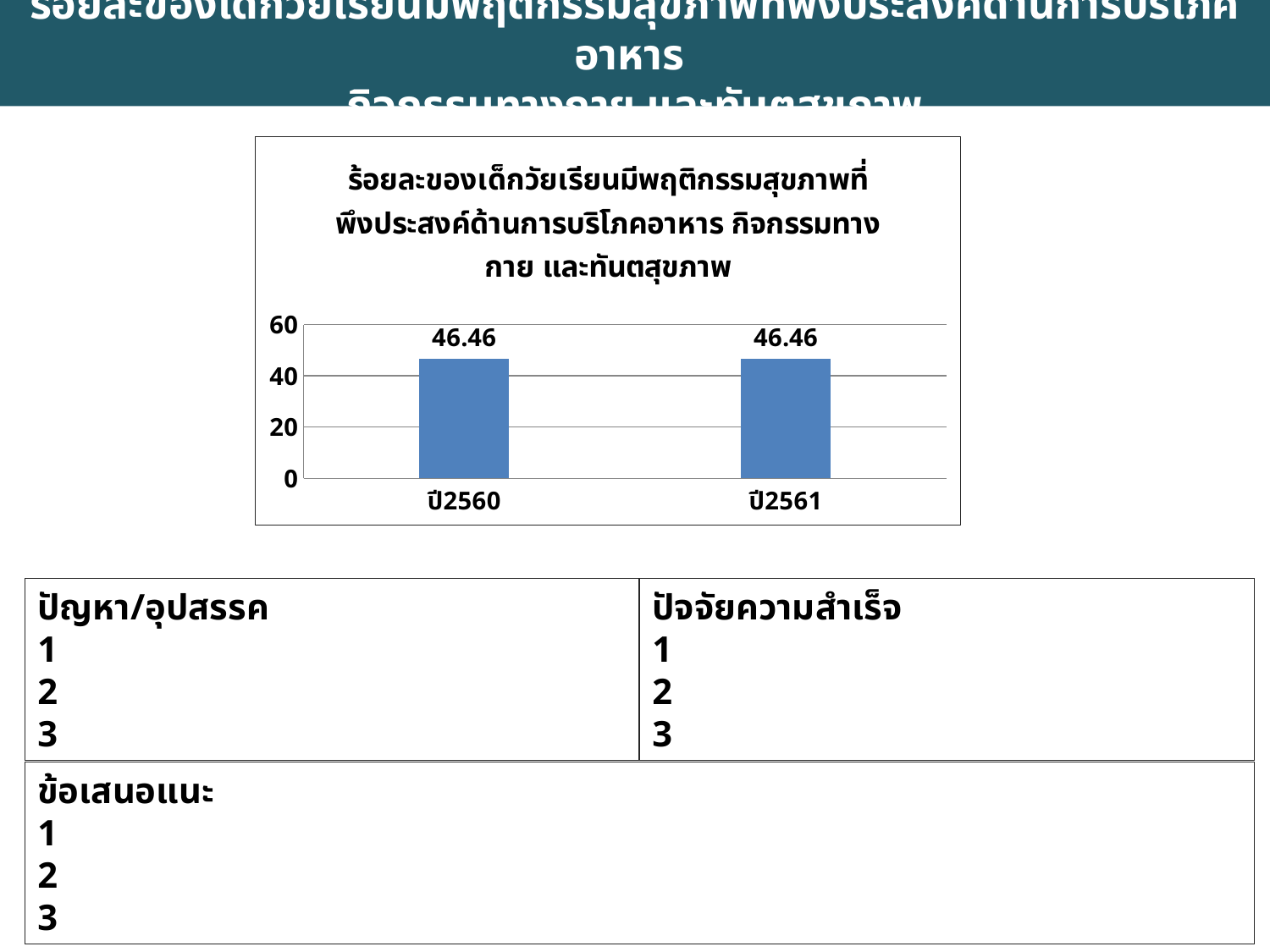
Is the value for ปี2561 larger than, smaller than, or equal to the value for ปี2560? equal Is the value for ปี2560 greater or less than 40? greater What colour are the bars in the chart? blue What is the value for ปี2560? 46.46 What is the value for ปี2561? 46.46 Do the values rise, fall, or stay the same from ปี2560 to ปี2561? stay the same What is the difference between the values for ปี2560 and ปี2561? 0 What kind of chart is shown on the slide? bar chart How many categories are shown on the x axis? 2 What is the highest value shown on the y axis? 60 Is the value for ปี2561 greater or less than 60? less